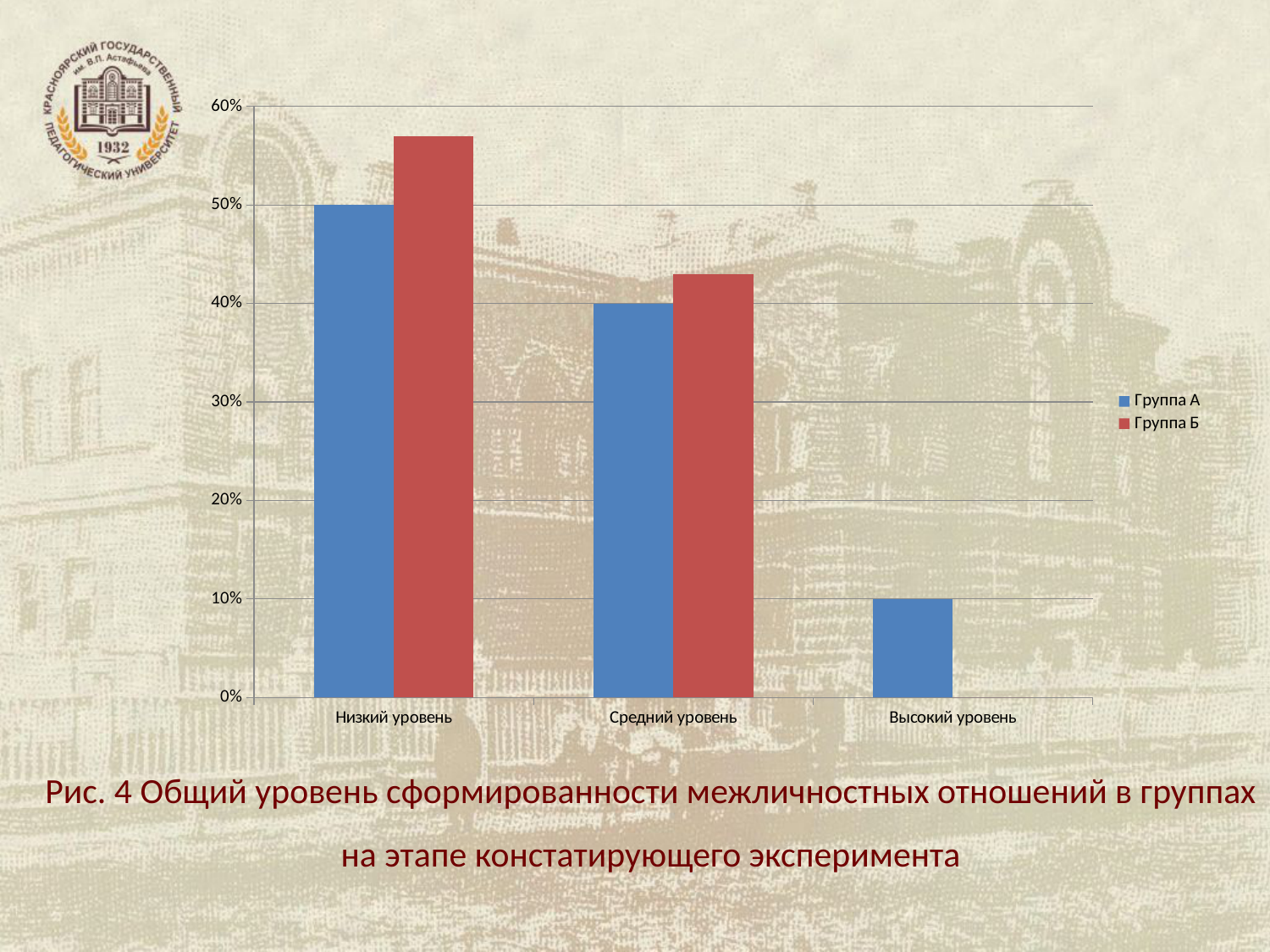
At Низкий уровень, which group has the larger value, Группа А or Группа Б? Группа Б Is the value for Группа Б at Средний уровень greater or less than 40%? greater What is the value for Группа А at Высокий уровень? 10% Which category has the highest value for Группа А? Низкий уровень What is the value for Группа А at Низкий уровень? 50% What kind of chart is shown on the slide? bar chart How many series does the legend list? 2 What is the value for Группа А at Средний уровень? 40% What is the difference between the Группа А values at Низкий уровень and Высокий уровень? 40% How many categories are shown on the x axis? 3 Which category has the lowest value for Группа А? Высокий уровень Is the value for Группа Б at Низкий уровень greater or less than 50%? greater